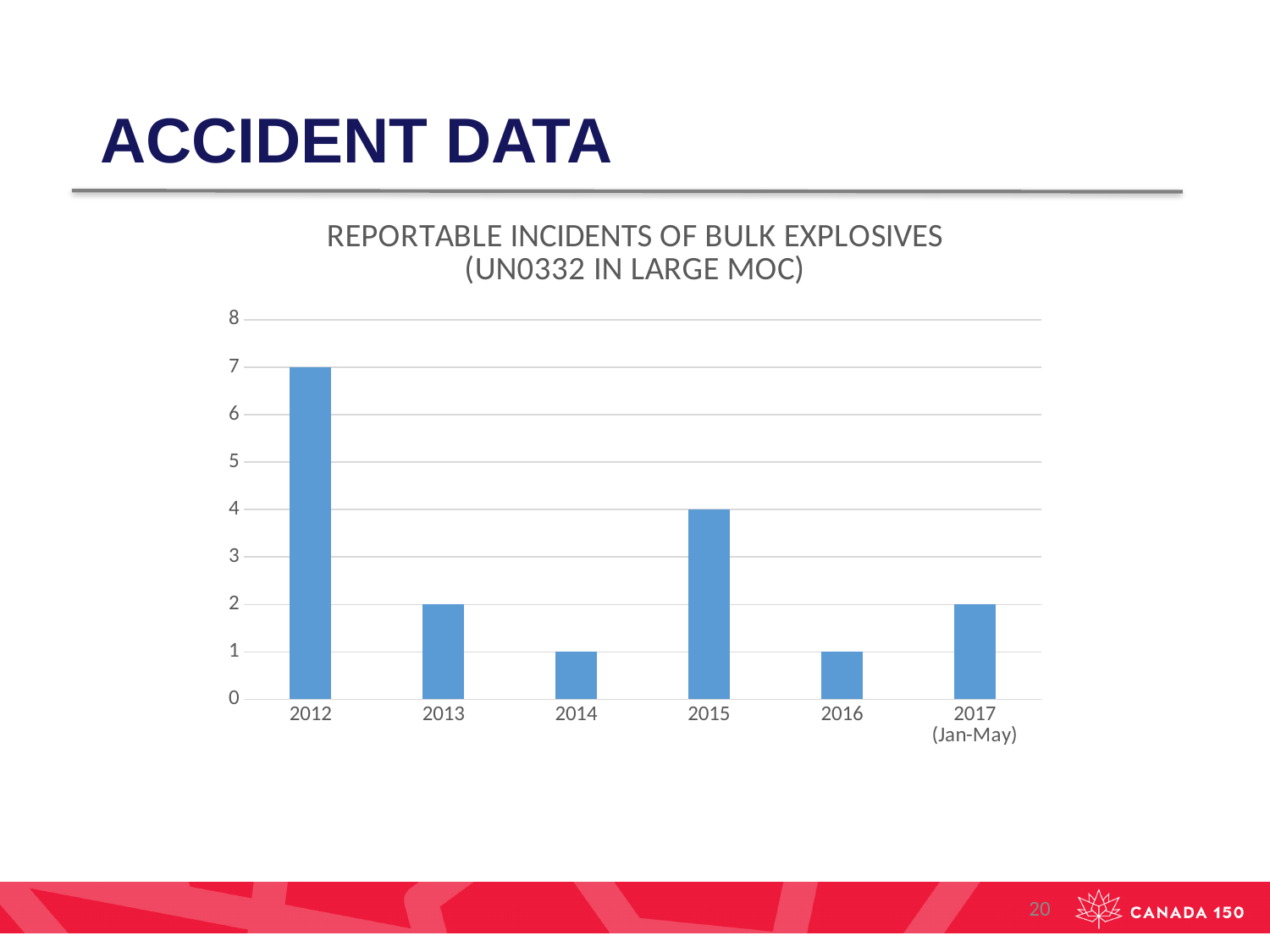
Which years have the lowest number of reportable incidents? 2014 and 2016 How many categories are shown on the x axis? 6 What is the difference between the values for 2012 and 2015? 3 Is the value for 2012 greater or less than 5? greater Which is larger, the value for 2013 or the value for 2014? 2013 What is the title of the chart? REPORTABLE INCIDENTS OF BULK EXPLOSIVES (UN0332 IN LARGE MOC) Do the values rise or fall from 2012 to 2014? fall What is the value for 2017 (Jan-May)? 2 What kind of chart is shown on the slide? bar chart What is the value for 2015? 4 Which year has the highest number of reportable incidents? 2012 What is the value for 2012? 7